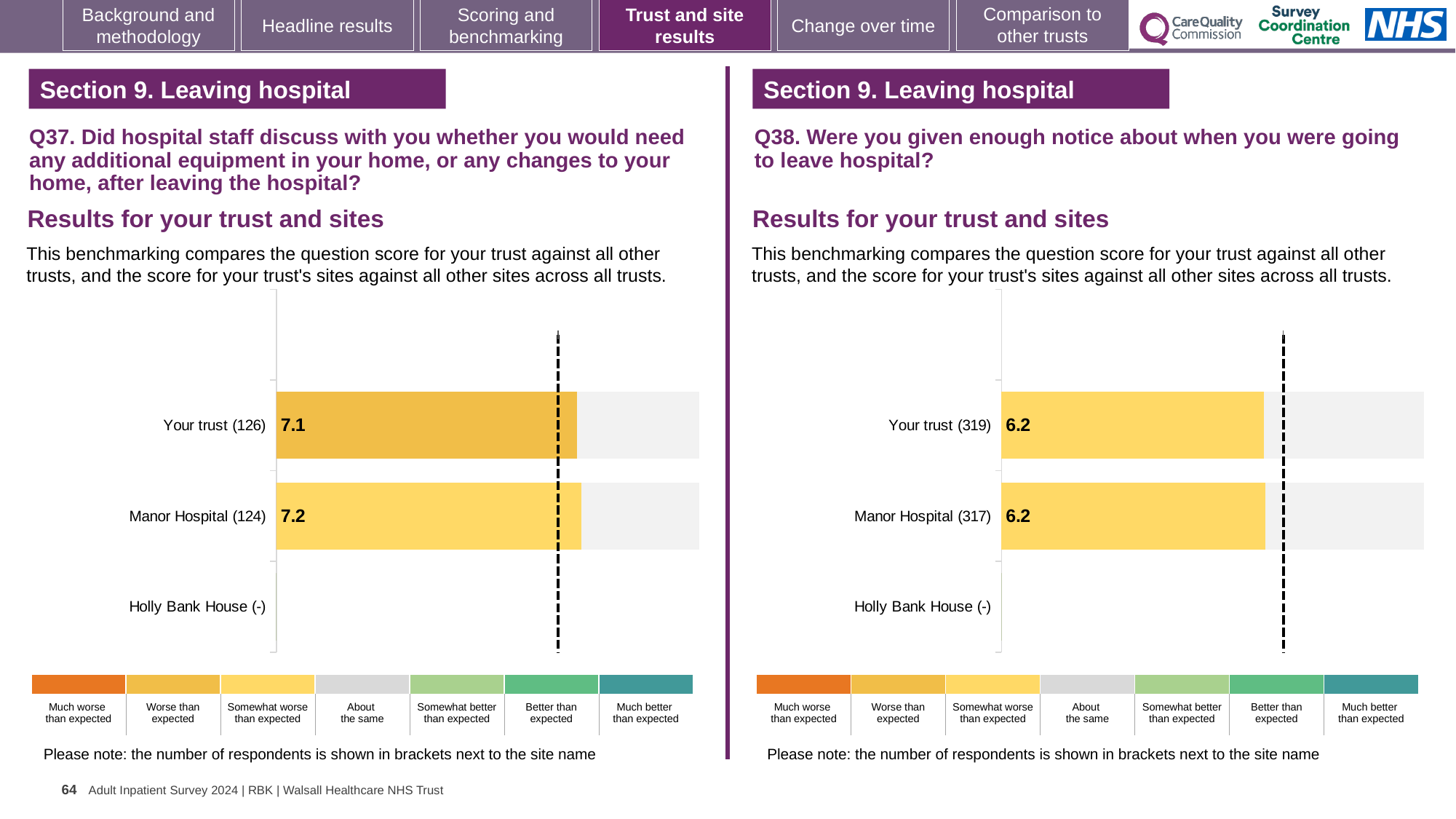
What kind of chart is used on the Q37 chart (left)? Bar chart On the Q38 chart (right), which category has no score shown? Holly Bank House On the Q37 chart (left), what is the score for Your trust? 7.1 On the Q37 chart (left), what is the score for Manor Hospital? 7.2 On the Q37 chart (left), which has the higher score, Your trust or Manor Hospital? Manor Hospital On the Q37 chart (left), what is the difference between the Manor Hospital score and the Your trust score? 0.1 On the Q38 chart (right), what is the score for Manor Hospital? 6.2 On the Q38 chart (right), what is the score for Your trust? 6.2 How many site/trust categories are listed on the Q38 chart (right)? 3 On the Q37 chart (left), how many respondents are shown in brackets for Your trust? 126 On the Q37 chart (left), which benchmark category does the colour of the Your trust bar correspond to in the legend? Worse than expected On the Q38 chart (right), how many respondents are shown in brackets for Manor Hospital? 317